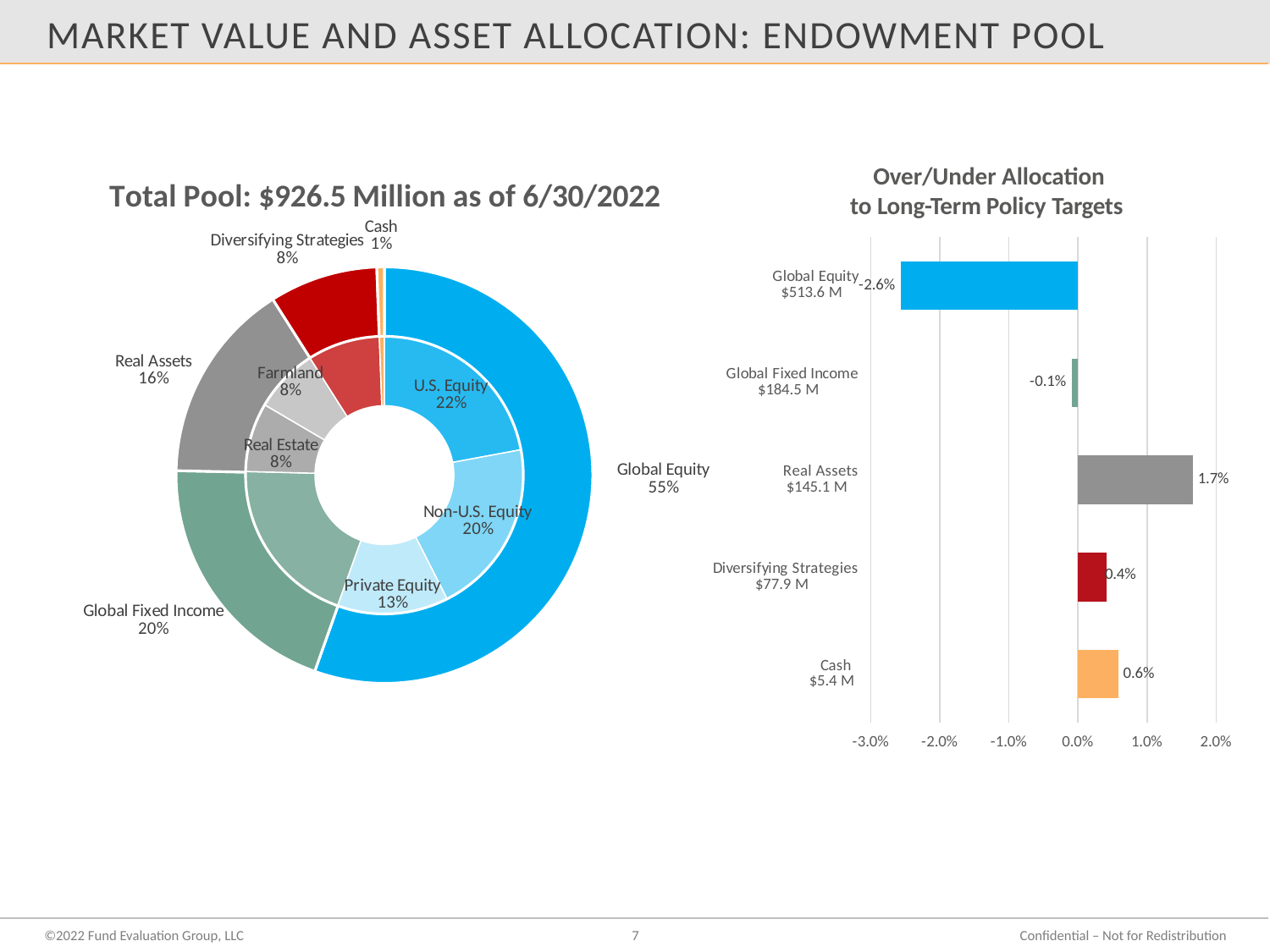
In the 'Over/Under Allocation to Long-Term Policy Targets' chart, which category has the lowest value? Global Equity In the 'Total Pool: $926.5 Million as of 6/30/2022' chart, which is larger, U.S. Equity or Non-U.S. Equity? U.S. Equity What kind of chart is the 'Over/Under Allocation to Long-Term Policy Targets' chart? Bar chart What kind of chart is the 'Total Pool: $926.5 Million as of 6/30/2022' chart? Donut chart In the 'Over/Under Allocation to Long-Term Policy Targets' chart, what is the value for Global Equity? -2.6% In the 'Total Pool: $926.5 Million as of 6/30/2022' chart, what share of the pool is Global Equity? 55% In the 'Over/Under Allocation to Long-Term Policy Targets' chart, what is the difference between the values for Cash and Diversifying Strategies? 0.2% In the 'Over/Under Allocation to Long-Term Policy Targets' chart, how many categories are shown? 5 In the 'Over/Under Allocation to Long-Term Policy Targets' chart, what market value is shown for Global Fixed Income? $184.5 M In the 'Over/Under Allocation to Long-Term Policy Targets' chart, what is the value for Real Assets? 1.7% In the 'Over/Under Allocation to Long-Term Policy Targets' chart, which category has the highest value? Real Assets In the 'Total Pool: $926.5 Million as of 6/30/2022' chart, what share of the pool is Private Equity? 13%